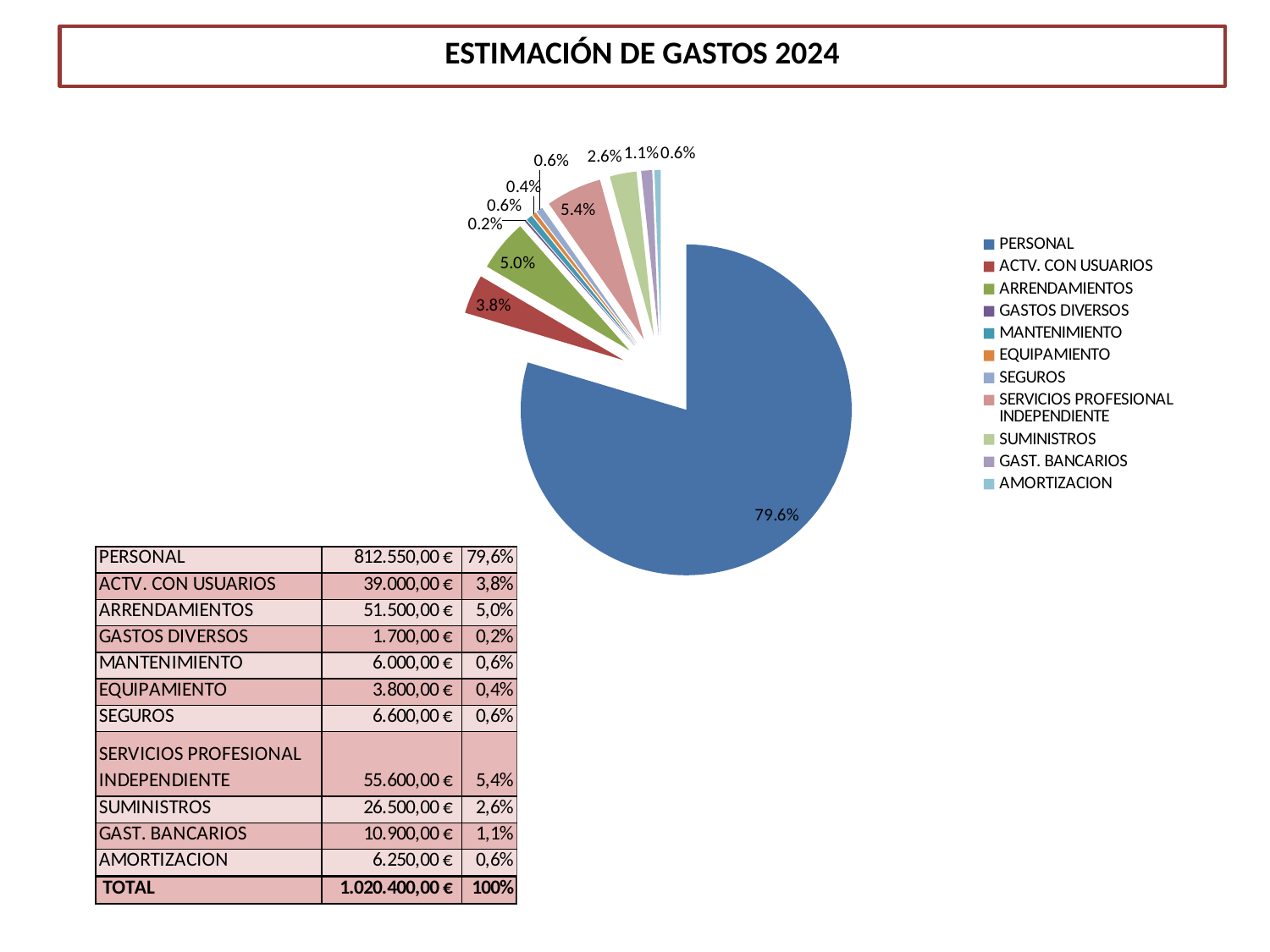
What share of the pie does ACTV. CON USUARIOS represent? 3.8% Which category has the smallest slice of the pie? GASTOS DIVERSOS What is the difference in percentage points between the PERSONAL slice and the SERVICIOS PROFESIONAL INDEPENDIENTE slice? 74.2% What share of the pie does ARRENDAMIENTOS represent? 5.0% Which slice is larger, ARRENDAMIENTOS or ACTV. CON USUARIOS? ARRENDAMIENTOS What share of the pie does SUMINISTROS represent? 2.6% What is the title of the slide containing the pie chart? ESTIMACIÓN DE GASTOS 2024 How many categories does the legend of the pie chart list? 11 Which category has the largest slice of the pie? PERSONAL What kind of chart is shown on the slide? pie chart